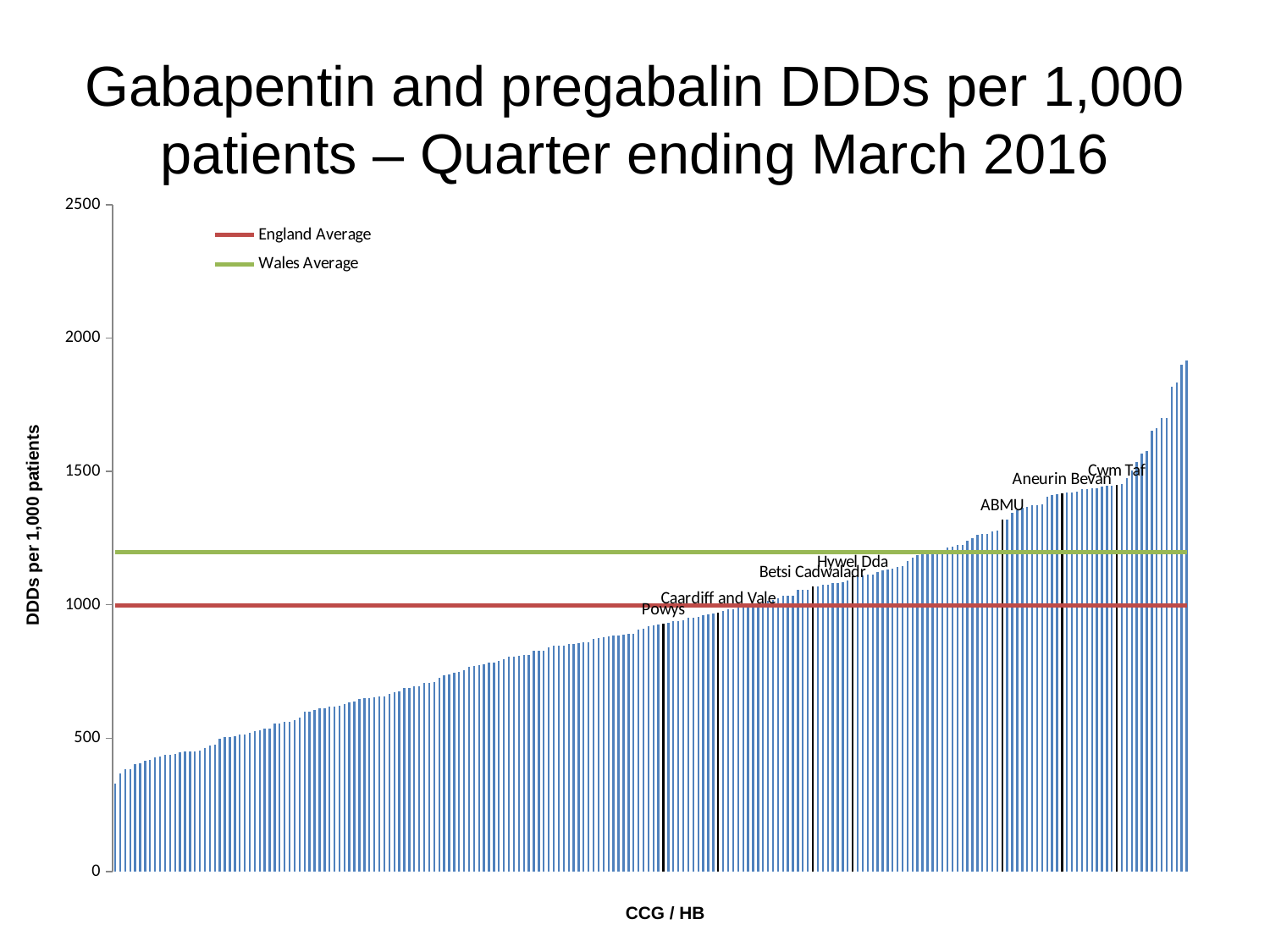
How many entries does the chart legend list? 2 Is the value for Hywel Dda greater or less than 1000? greater Is the value for ABMU greater or less than 1000? greater Which of the labelled Welsh health boards has the lowest value? Powys Do the bar values rise or fall moving from left to right along the x axis? rise Is the value for Powys greater or less than 1000? less Which two averages are shown as horizontal lines on the chart? England Average and Wales Average Which of the labelled Welsh health boards has the highest value? Cwm Taf What is the title of the vertical axis? DDDs per 1,000 patients Which is higher on the chart, the Wales Average line or the England Average line? Wales Average What kind of chart is shown on the slide? bar chart